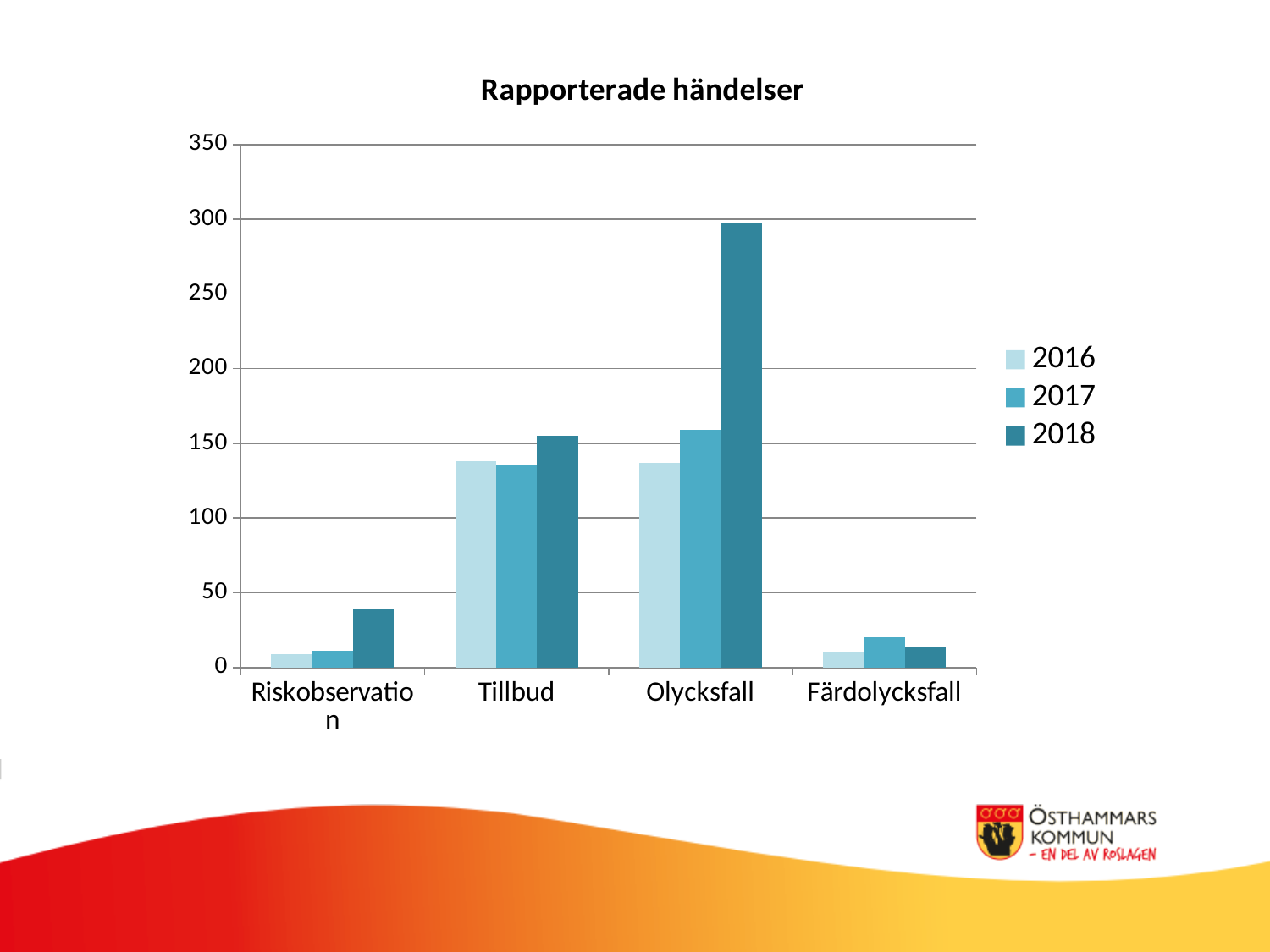
What kind of chart is shown on the slide? bar chart Which years are listed in the legend? 2016, 2017, 2018 How many series does the legend list? 3 Which category has the highest value for 2018? Olycksfall Is the 2018 value for Tillbud greater or less than 200? less Which category has the lowest value for 2018? Färdolycksfall What is the title of the chart? Rapporterade händelser Is the 2018 value for Riskobservation greater or less than 50? less Do the values for Olycksfall rise or fall from 2016 to 2018? rise Is the 2018 value for Olycksfall greater or less than 250? greater How many categories are shown on the x axis? 4 Which is larger for 2018: Olycksfall or Tillbud? Olycksfall